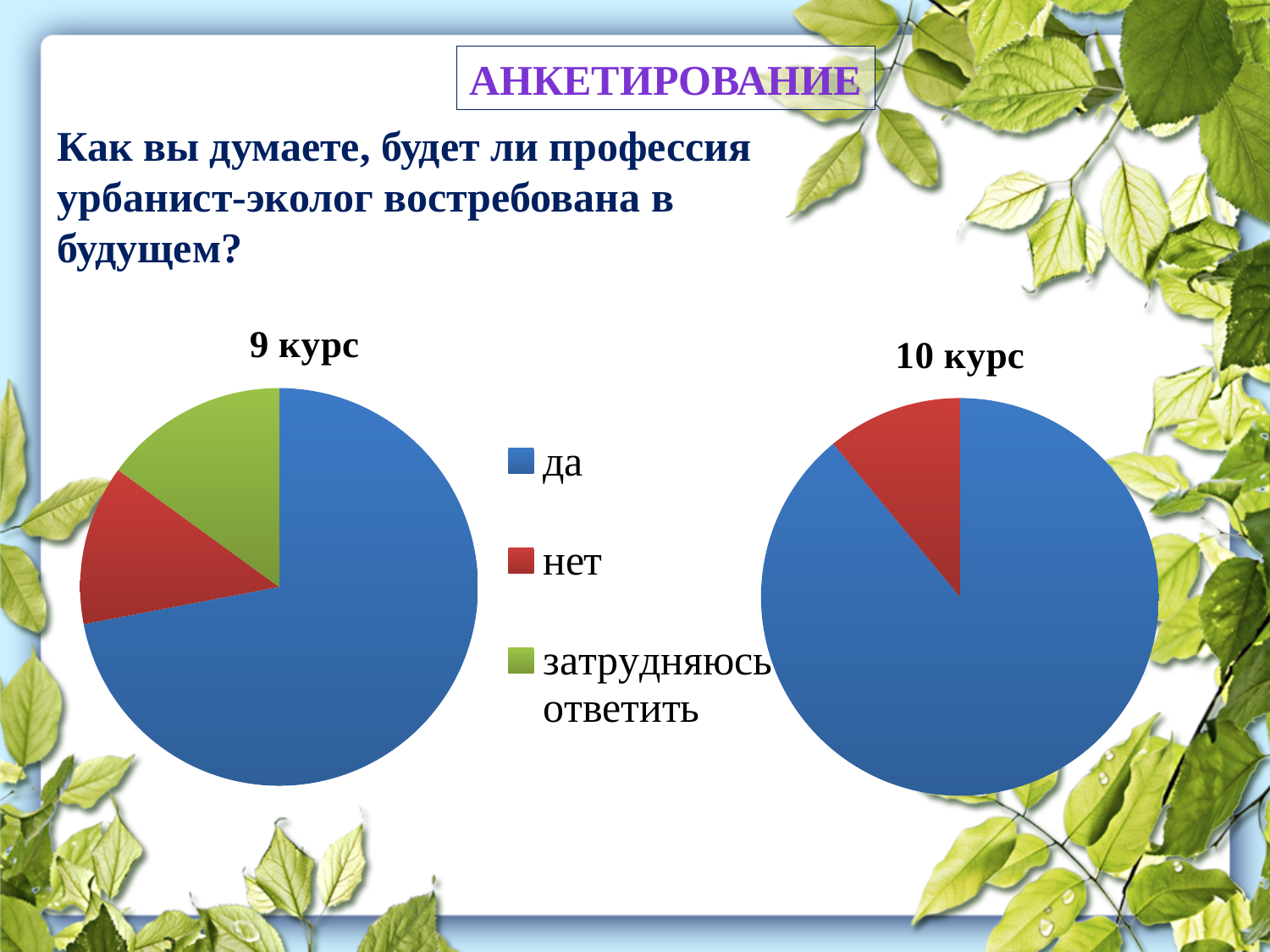
How many categories does the legend list? 3 In the "9 курс" chart, which category has the largest slice? да In the "10 курс" chart, which visible category has the smallest slice? нет What colour represents "затрудняюсь ответить" in the legend? green How many slices are visible in the "10 курс" pie chart? 2 In the "10 курс" chart, which is larger: the slice for "нет" or the slice for "да"? да What is the title of the pie chart on the left? 9 курс What kind of chart is the "10 курс" chart? pie chart How many slices are visible in the "9 курс" pie chart? 3 In the "9 курс" chart, which is larger: the slice for "да" or the slice for "нет"? да In the "10 курс" chart, which category has the largest slice? да What kind of chart is the "9 курс" chart? pie chart